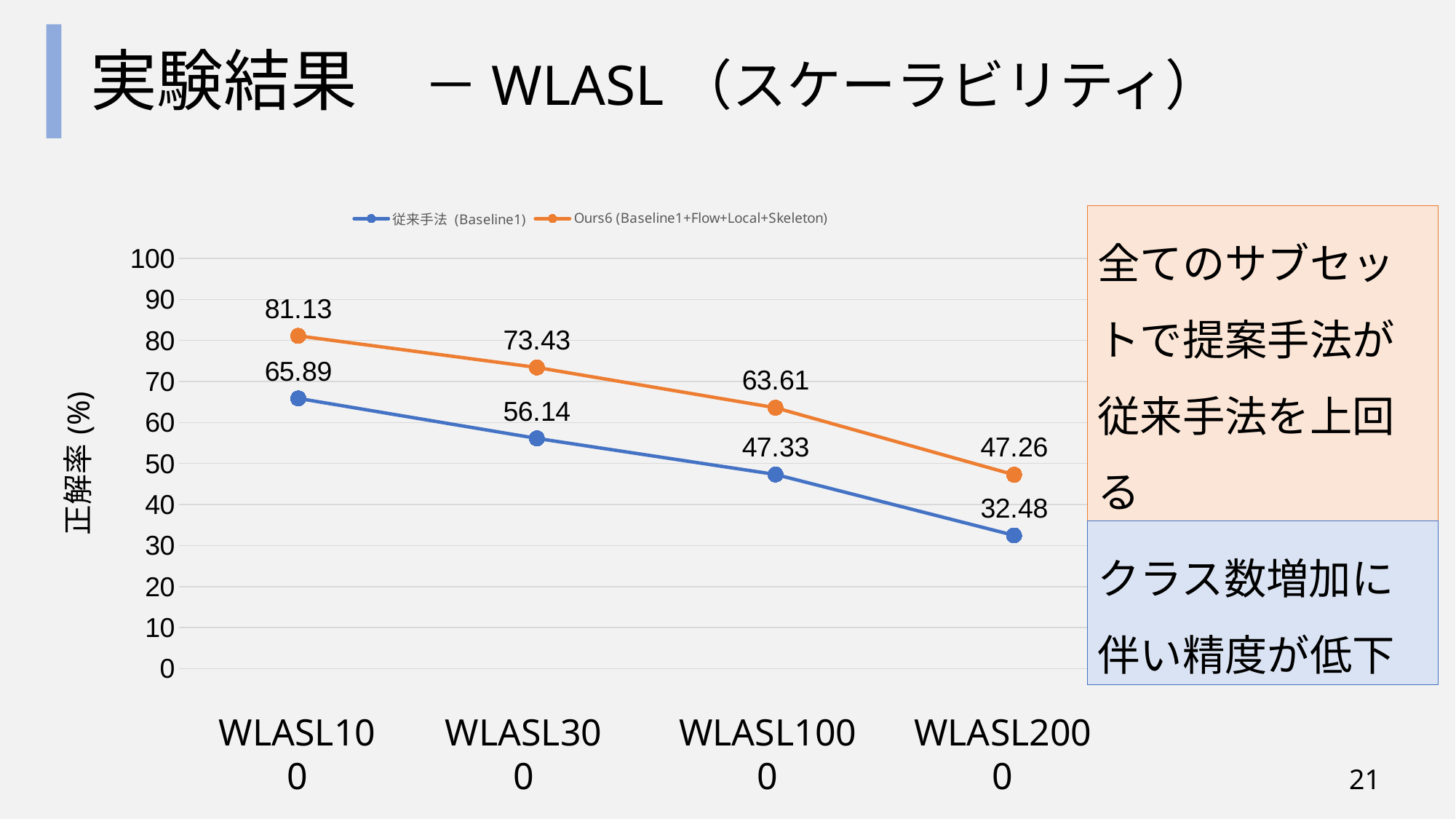
What is the difference between Ours6 and 従来手法 (Baseline1) at WLASL100? 15.24 What is the value for 従来手法 (Baseline1) at WLASL100? 65.89 How many series does the legend list? 2 At which subset does 従来手法 (Baseline1) have its lowest value? WLASL2000 What kind of chart is shown on the slide? Line chart What is the difference between Ours6 and 従来手法 (Baseline1) at WLASL2000? 14.78 Which series has the higher value at WLASL300, 従来手法 (Baseline1) or Ours6? Ours6 How many subsets are plotted on the x axis? 4 What is the value for 従来手法 (Baseline1) at WLASL1000? 47.33 What is the value for Ours6 (Baseline1+Flow+Local+Skeleton) at WLASL300? 73.43 At which subset does Ours6 (Baseline1+Flow+Local+Skeleton) reach its highest value? WLASL100 What is the value for Ours6 (Baseline1+Flow+Local+Skeleton) at WLASL2000? 47.26